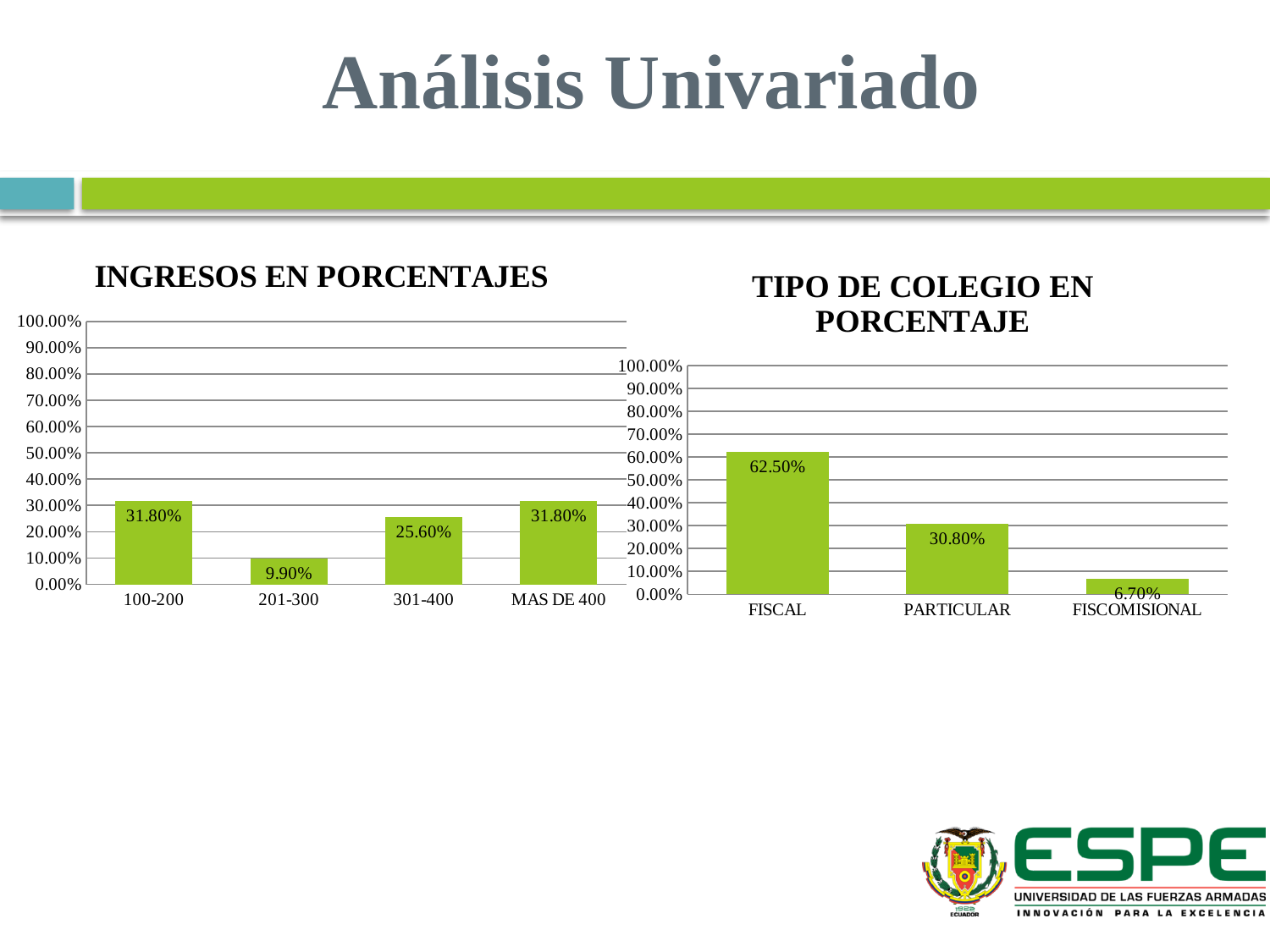
In the 'TIPO DE COLEGIO EN PORCENTAJE' chart, what is the value for FISCOMISIONAL? 6.70% In the 'INGRESOS EN PORCENTAJES' chart, is the value for 100-200 greater or less than 30.00%? greater In the 'TIPO DE COLEGIO EN PORCENTAJE' chart, what is the value for FISCAL? 62.50% In the 'INGRESOS EN PORCENTAJES' chart, what is the difference between the values for 301-400 and 201-300? 15.70% In the 'TIPO DE COLEGIO EN PORCENTAJE' chart, what is the difference between the values for FISCAL and PARTICULAR? 31.70% In the 'INGRESOS EN PORCENTAJES' chart, what is the value for 201-300? 9.90% In the 'INGRESOS EN PORCENTAJES' chart, how many categories are shown? 4 In the 'INGRESOS EN PORCENTAJES' chart, what is the value for 301-400? 25.60% In the 'TIPO DE COLEGIO EN PORCENTAJE' chart, which category has the highest value? FISCAL In the 'INGRESOS EN PORCENTAJES' chart, which category has the lowest value? 201-300 In the 'TIPO DE COLEGIO EN PORCENTAJE' chart, which is larger, PARTICULAR or FISCOMISIONAL? PARTICULAR What kind of chart is the 'TIPO DE COLEGIO EN PORCENTAJE' chart? Bar chart